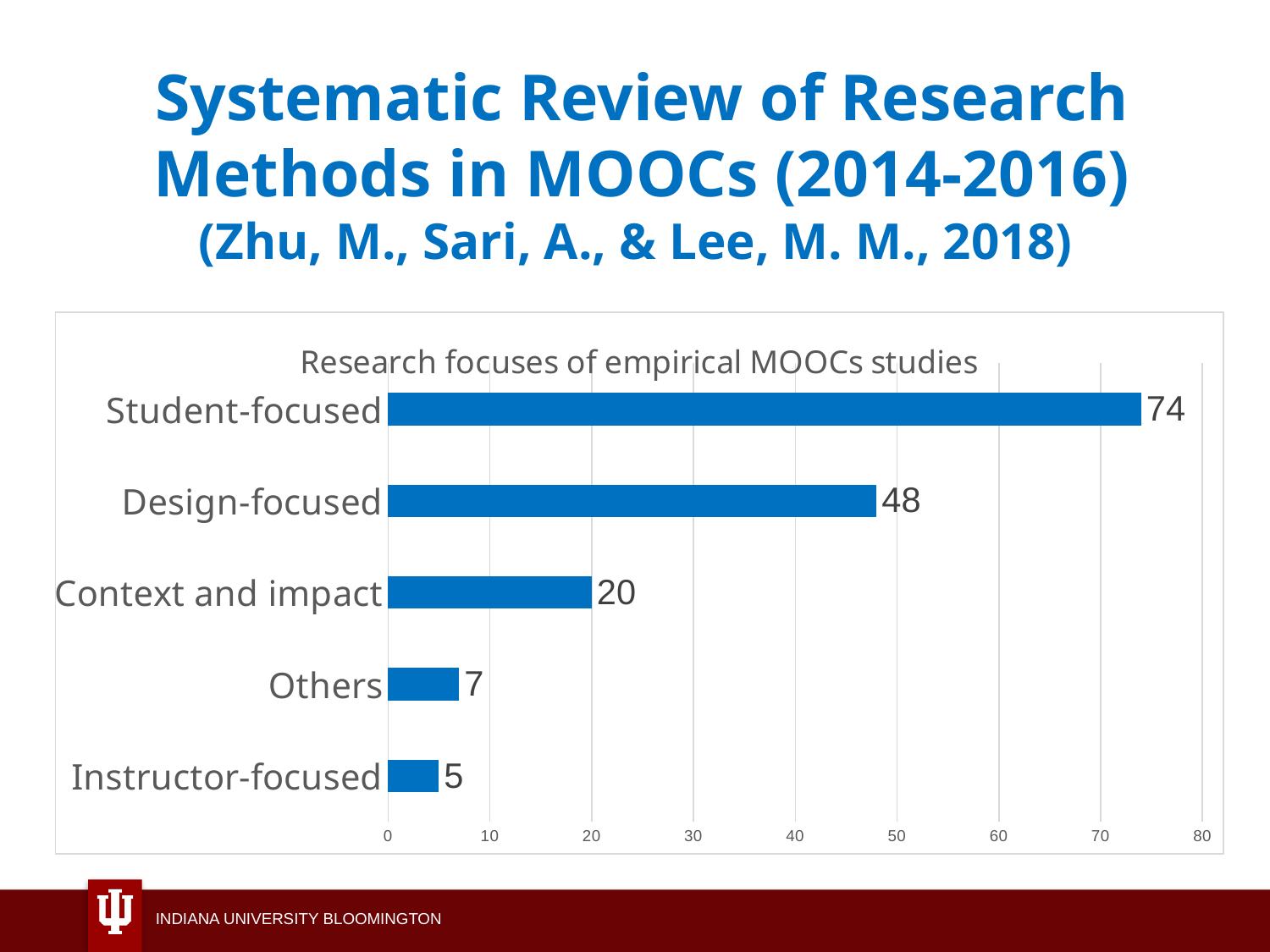
Which is larger, the value for Others or the value for Instructor-focused? Others What is the value for Context and impact? 20 What kind of chart is shown on the slide? Bar chart What is the value for Instructor-focused? 5 What is the difference between the values for Student-focused and Design-focused? 26 What is the title of the chart? Research focuses of empirical MOOCs studies Is the value for Design-focused greater or less than 40? greater Which category has the highest value? Student-focused What is the value for Student-focused? 74 Which category has the lowest value? Instructor-focused How many categories are shown in the chart? 5 What is the value for Design-focused? 48